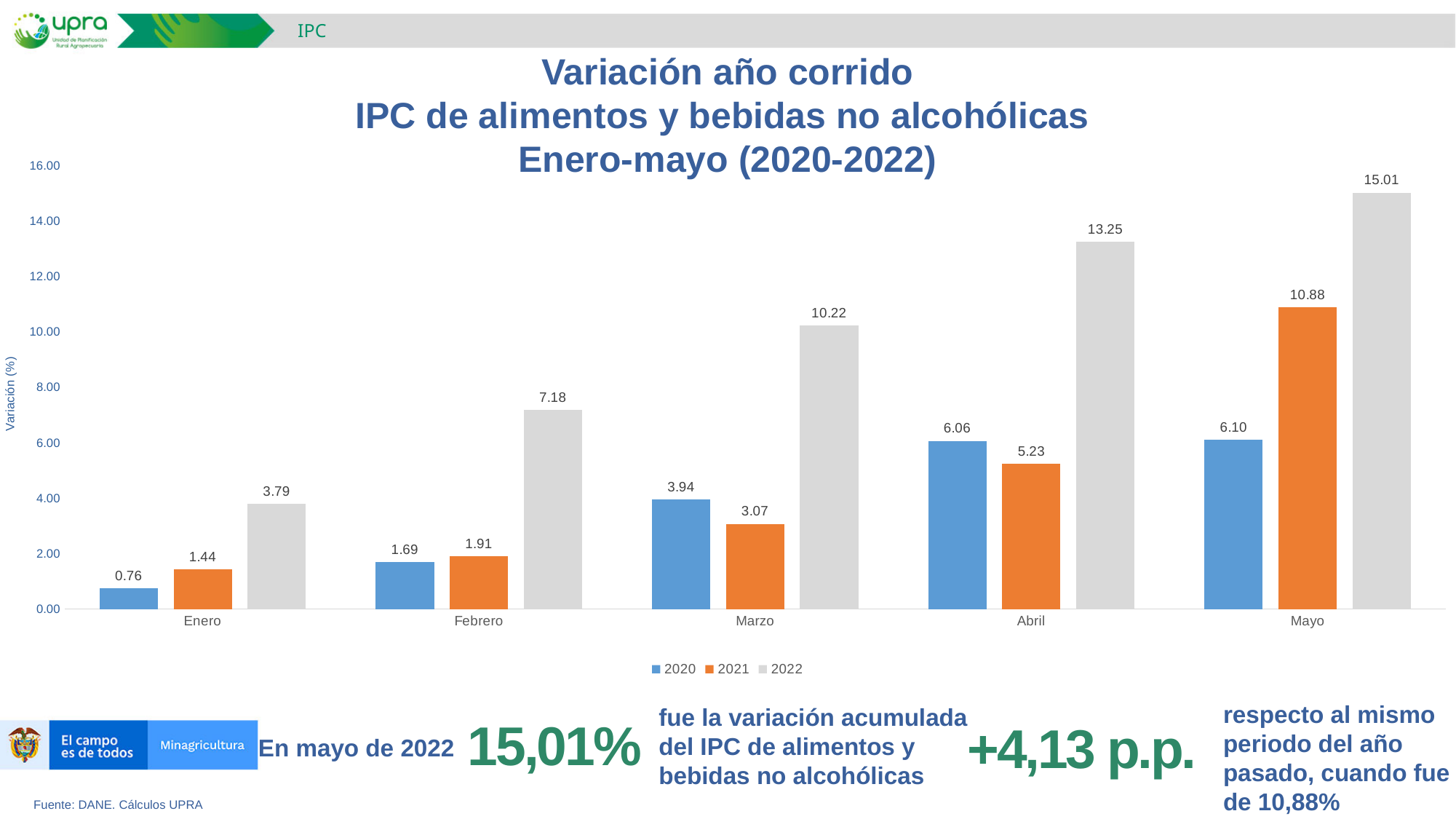
Is the value for 2022 in Abril greater or less than 12.00? greater Do the values for the 2022 series rise or fall from Enero to Mayo? Rise What is the difference between the 2022 and 2021 values in Mayo? 4.13 What kind of chart is shown on the slide? Bar chart Which month has the highest value for the 2022 series? Mayo Which month has the lowest value for the 2021 series? Enero What is the value for 2022 in Mayo? 15.01 What is the value for 2020 in Enero? 0.76 Which is larger in Abril: the 2020 value or the 2021 value? 2020 What is the value for 2021 in Marzo? 3.07 How many series does the legend list? 3 How many months are shown on the x axis? 5